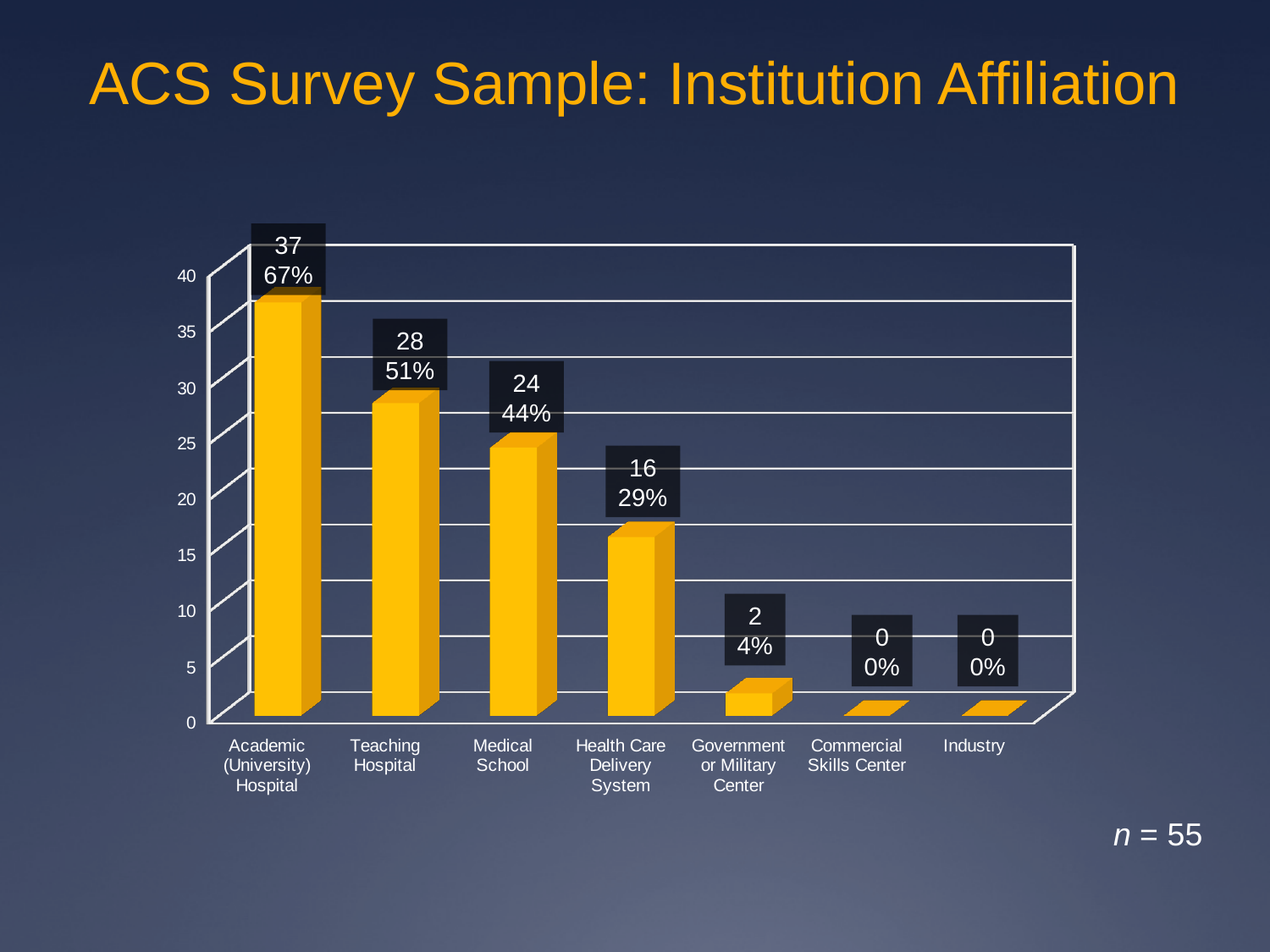
What is the difference in count between Academic (University) Hospital and Teaching Hospital? 9 Which institution affiliation has the highest count? Academic (University) Hospital What is the count for Medical School? 24 Which has a larger count, Medical School or Health Care Delivery System? Medical School What kind of chart is shown on the slide? bar chart What percentage is shown for Teaching Hospital? 51% How many institution affiliation categories are shown on the x axis? 7 Do the values rise or fall moving from left to right along the x axis? fall What is the count for Government or Military Center? 2 Is the value for Health Care Delivery System greater or less than 20? less What is the title of the chart? ACS Survey Sample: Institution Affiliation What is the sample size n shown on the slide? 55